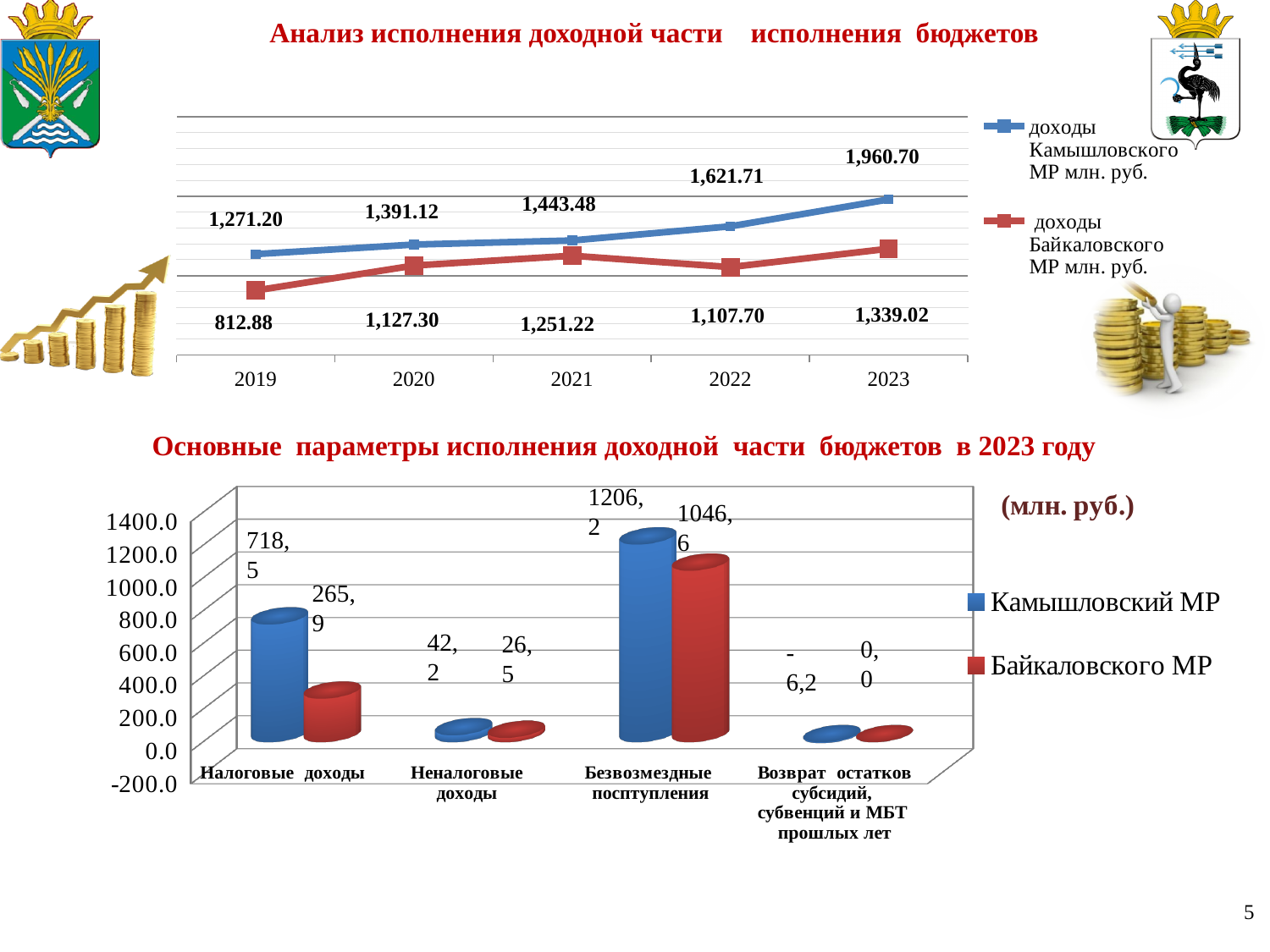
In the top line chart, what is the value for доходы Камышловского МР in 2023? 1,960.70 In the top line chart, what is the value for доходы Байкаловского МР in 2019? 812.88 In the top line chart, how many years are shown on the x axis? 5 In the bottom bar chart, which category has the highest value for Камышловский МР? Безвозмездные поступления In the bottom bar chart, which is larger for Неналоговые доходы: Камышловский МР or Байкаловского МР? Камышловский МР In the top line chart, does the value for доходы Камышловского МР rise or fall from 2019 to 2023? rise In the top line chart, in which year is the value for доходы Байкаловского МР lowest? 2019 In the top line chart, what is the difference between доходы Камышловского МР and доходы Байкаловского МР in 2023? 621.68 What kind of chart is the top chart on the slide? line chart In the bottom bar chart, what is the value for Байкаловского МР for Безвозмездные поступления? 1046,6 How many series does the legend of the bottom bar chart list? 2 In the bottom bar chart, what is the value for Камышловский МР for Налоговые доходы? 718,5